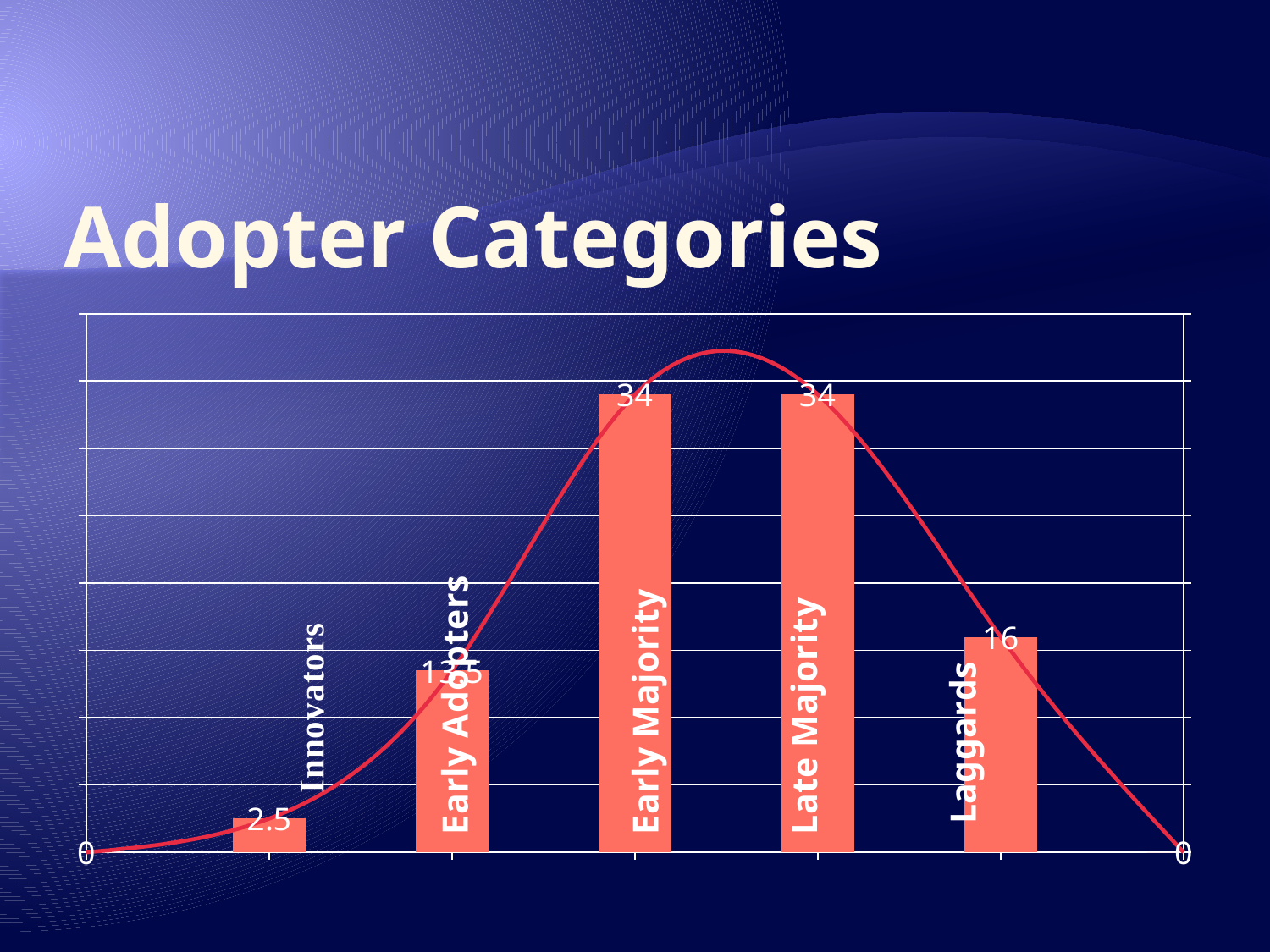
What is the difference between the values for Laggards and Innovators? 13.5 What is the value for Late Majority? 34 What kind of chart is shown on the slide? bar chart How many categories are shown in the chart? 5 What is the difference between the values for Early Majority and Laggards? 18 What is the value for Laggards? 16 Which is larger, the value for Laggards or the value for Innovators? Laggards Which category has the lowest value? Innovators What is the value for Early Majority? 34 What is the title of the slide? Adopter Categories Which two categories share the highest value? Early Majority and Late Majority What is the value for Innovators? 2.5